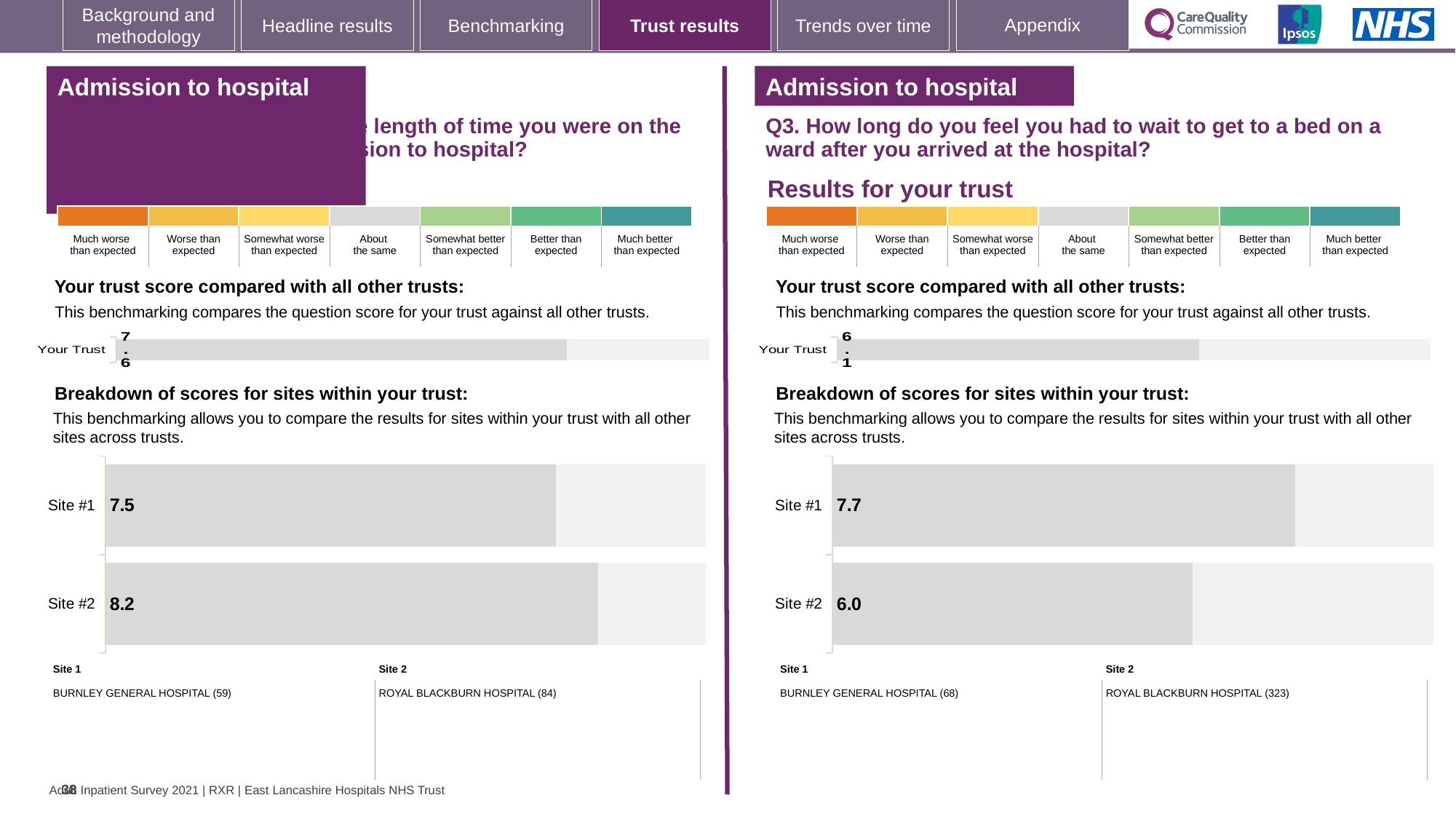
What type of chart is used for the breakdown of scores for sites within your trust on the right-hand side of the slide? Bar chart How many sites are shown in the Q3 breakdown of scores for sites within your trust chart? 2 For Q3 (wait to get to a bed on a ward), what is the score shown for Site #2? 6.0 On the left-hand side of the slide, what is the 'Your Trust' score in the trust score comparison chart? 7.6 On the left-hand side of the slide, what is the score shown for Site #2 in the breakdown of scores for sites within your trust? 8.2 On the left-hand side of the slide, what is the difference between the Site #2 and Site #1 scores? 0.7 For Q3 (wait to get to a bed on a ward), what is the score shown for Site #1? 7.7 For Q3 (wait to get to a bed on a ward), what is the difference between the Site #1 and Site #2 scores? 1.7 For Q3 (wait to get to a bed on a ward), what is the 'Your Trust' score in the trust score comparison chart? 6.1 On the left-hand side of the slide, what is the score shown for Site #1 in the breakdown of scores for sites within your trust? 7.5 On the left-hand side of the slide, which site has the higher score in the breakdown of scores for sites within your trust? Site #2 For Q3 (wait to get to a bed on a ward), which site has the lower score in the breakdown of scores for sites within your trust? Site #2